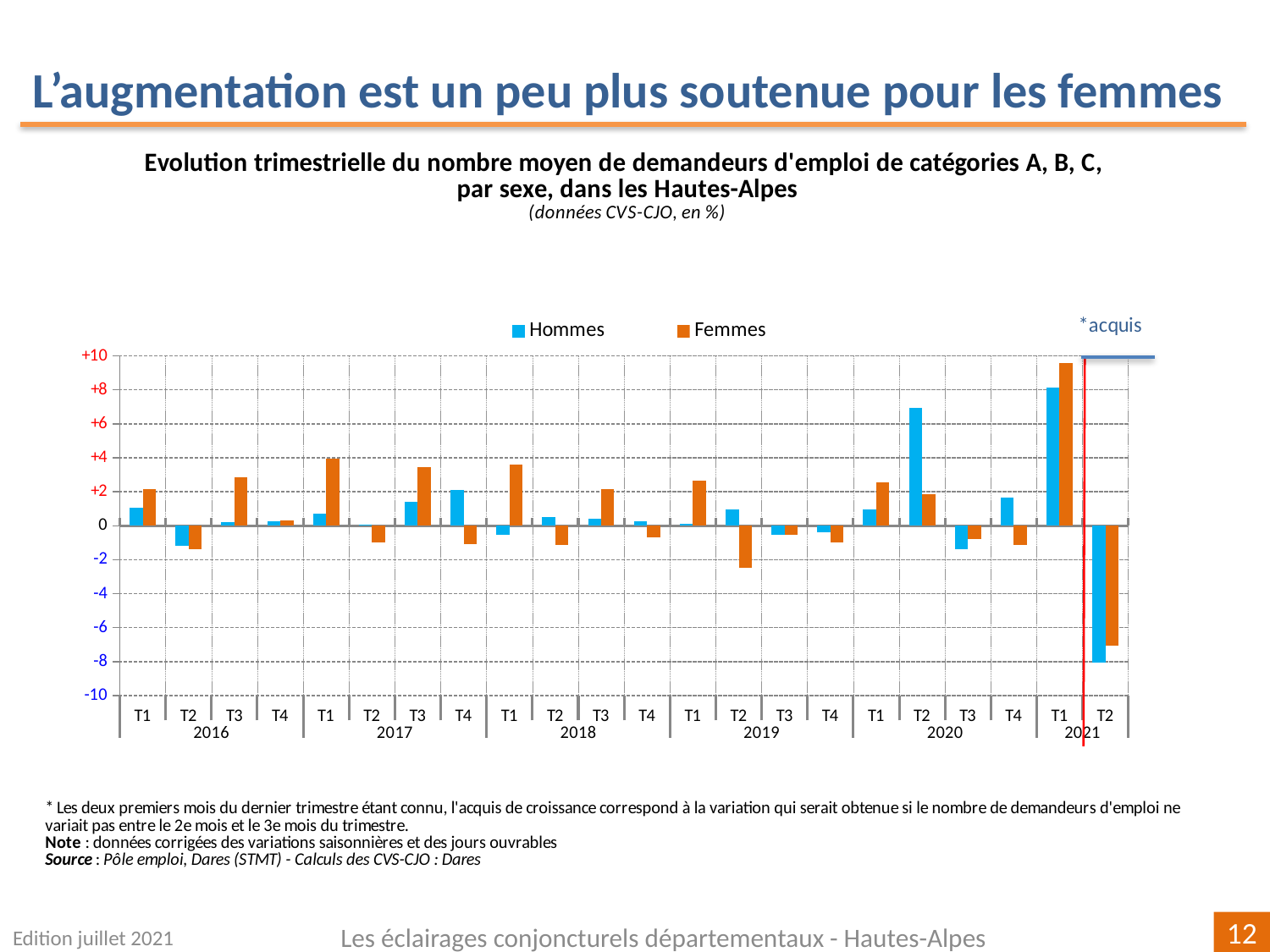
In which quarter is the value for Femmes the highest? T1 2021 Is the value for Hommes in T2 2020 greater or less than +6? greater Is the value for Femmes in T1 2021 greater or less than +8? greater How many series does the legend list? 2 What kind of chart is shown on the slide? Bar chart In which quarter is the value for Hommes the lowest? T2 2021 In T1 2017, which series has the larger value, Hommes or Femmes? Femmes In T2 2020, which series has the larger value, Hommes or Femmes? Hommes What are the two series named in the legend? Hommes and Femmes What colour are the bars for the Hommes series? Blue How many quarters are plotted along the x axis? 22 Is the value for Femmes in T2 2021 greater or less than -6? less